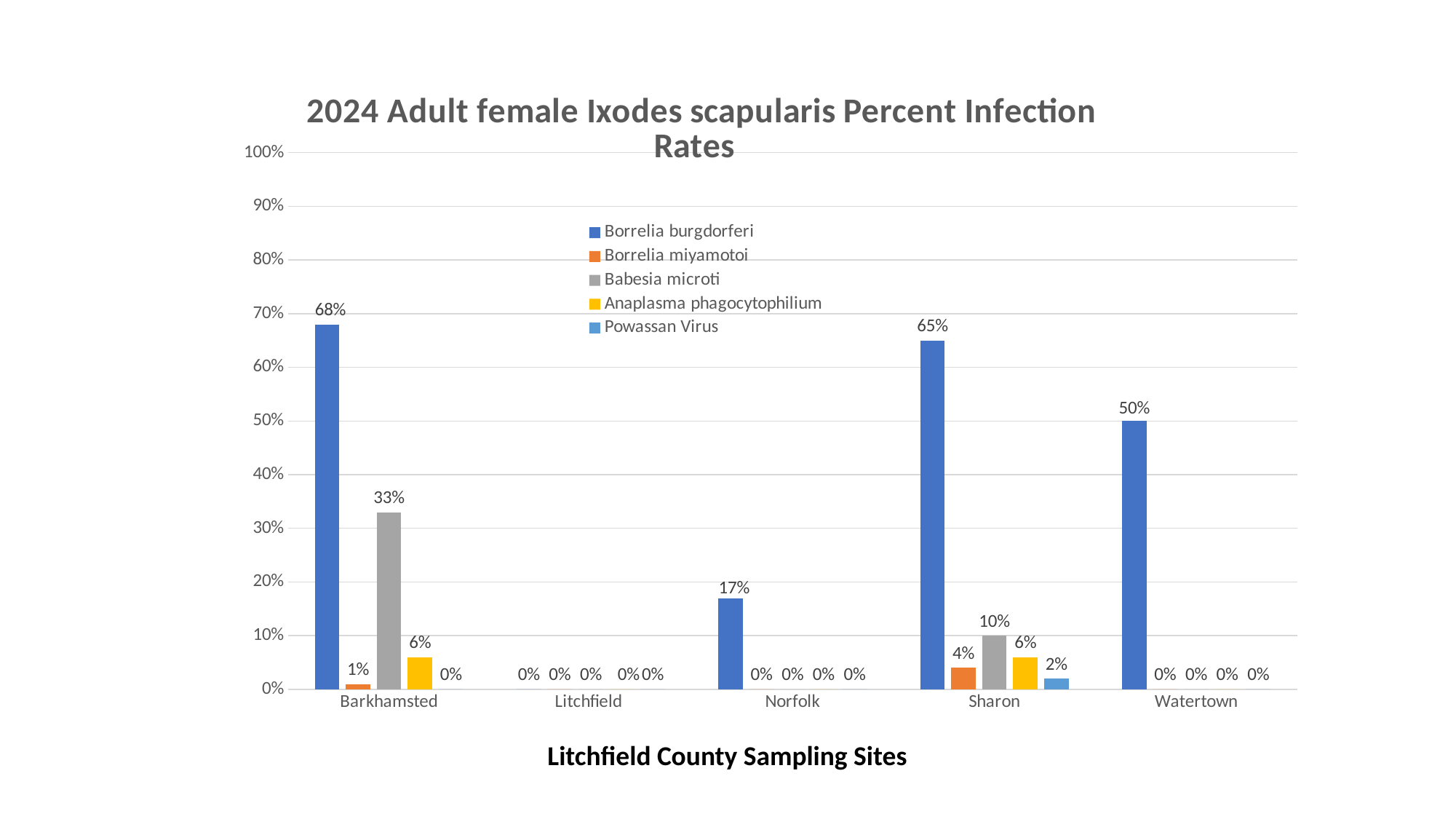
What is the Babesia microti infection rate at Barkhamsted? 33% What kind of chart is shown on the slide? Bar chart What is the Borrelia burgdorferi infection rate at Barkhamsted? 68% How many sampling sites are shown on the x axis? 5 What is the difference between the Borrelia burgdorferi infection rates at Barkhamsted and Sharon? 3% What is the x-axis title of the chart? Litchfield County Sampling Sites What is the Borrelia burgdorferi infection rate at Watertown? 50% What is the Powassan Virus infection rate at Sharon? 2% Which is larger, the Babesia microti rate at Barkhamsted or at Sharon? Barkhamsted How many series does the legend list? 5 Which sampling site has the highest Borrelia burgdorferi infection rate? Barkhamsted Which sampling site has the lowest Borrelia burgdorferi infection rate? Litchfield